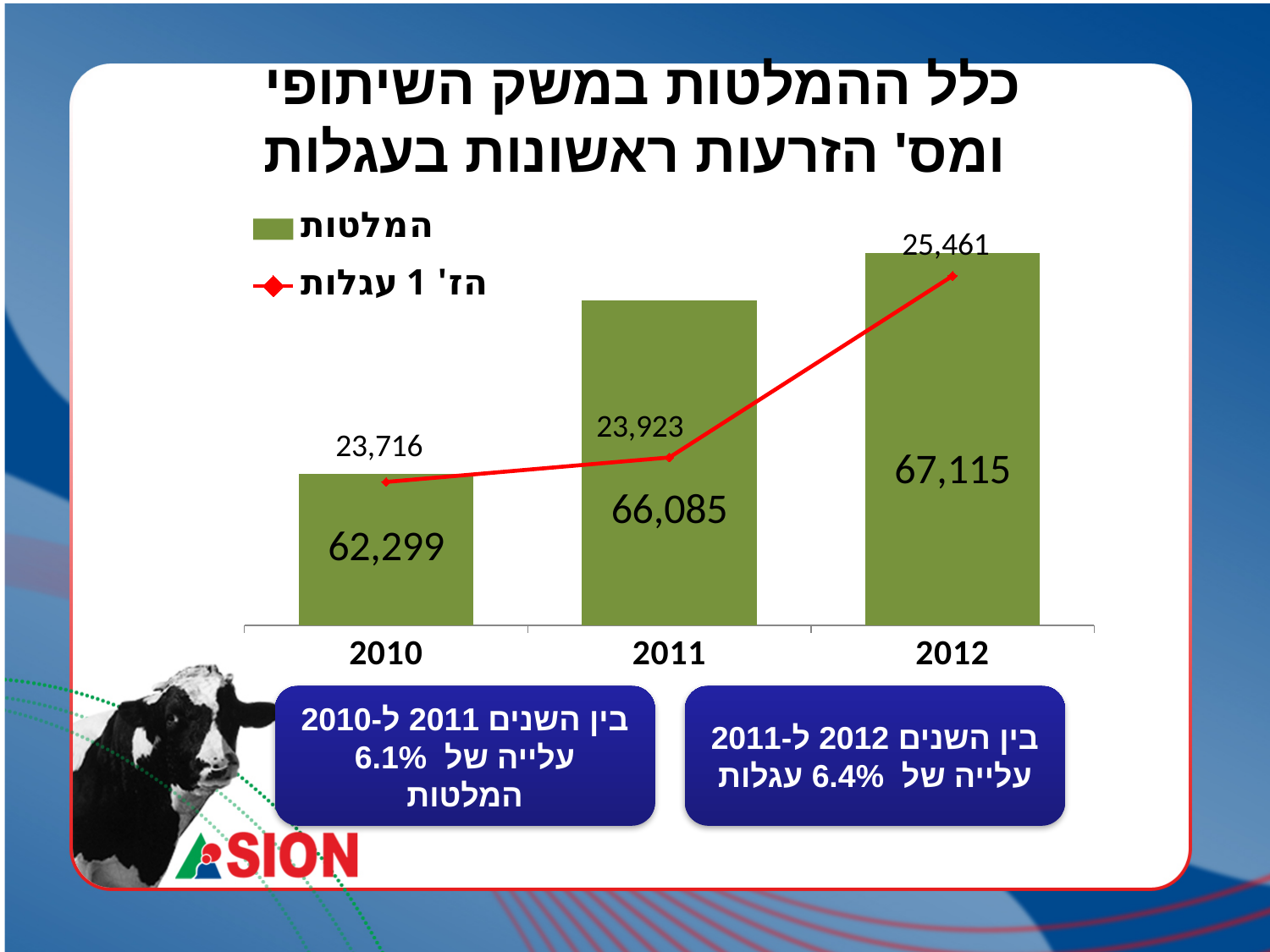
How many series does the legend list? 2 What is the difference between the המלטות values for 2012 and 2011? 1,030 Which year has the highest המלטות value? 2012 What is the difference between the הז' 1 עגלות values for 2012 and 2011? 1,538 What is the value of the המלטות bar for 2010? 62,299 Do the המלטות values rise or fall from 2010 to 2012? rise What is the value of the הז' 1 עגלות line for 2012? 25,461 What is the value of the המלטות bar for 2011? 66,085 Which year has the lowest הז' 1 עגלות value? 2010 Which is larger, the המלטות value for 2010 or for 2011? 2011 How many years are shown on the x axis? 3 What is the value of the הז' 1 עגלות line for 2010? 23,716